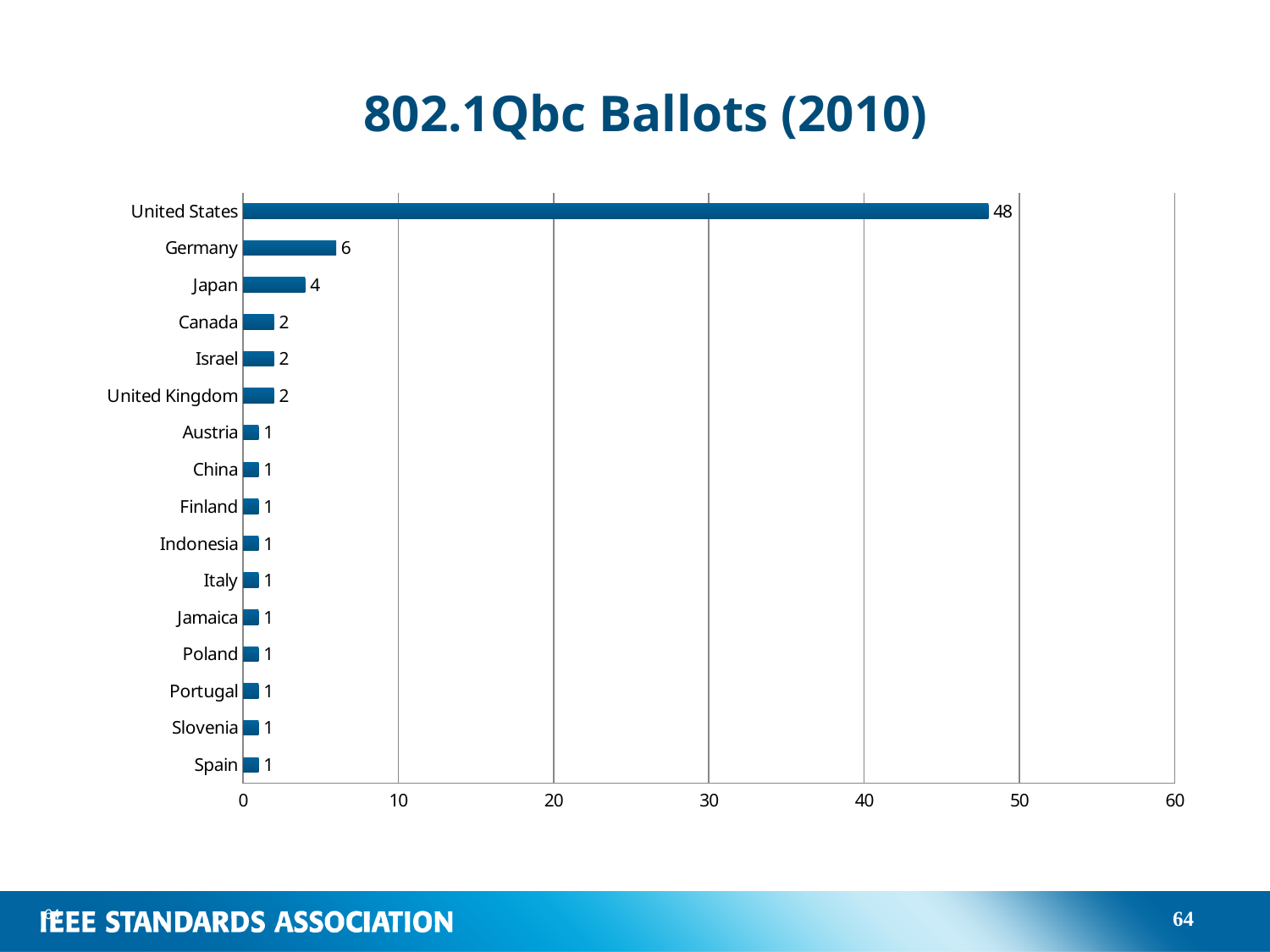
What is the title of the chart? 802.1Qbc Ballots (2010) What is the value for Germany? 6 What is the difference between the values for the United States and Germany? 42 How many countries are shown on the chart? 16 What is the difference between the values for Germany and Japan? 2 What is the value for Japan? 4 What is the value for Canada? 2 Is the value for the United States greater or less than 40? greater What is the value for the United States? 48 What kind of chart is shown on the slide? Bar chart Which country has the highest value? United States Which is larger, the value for Japan or the value for Israel? Japan